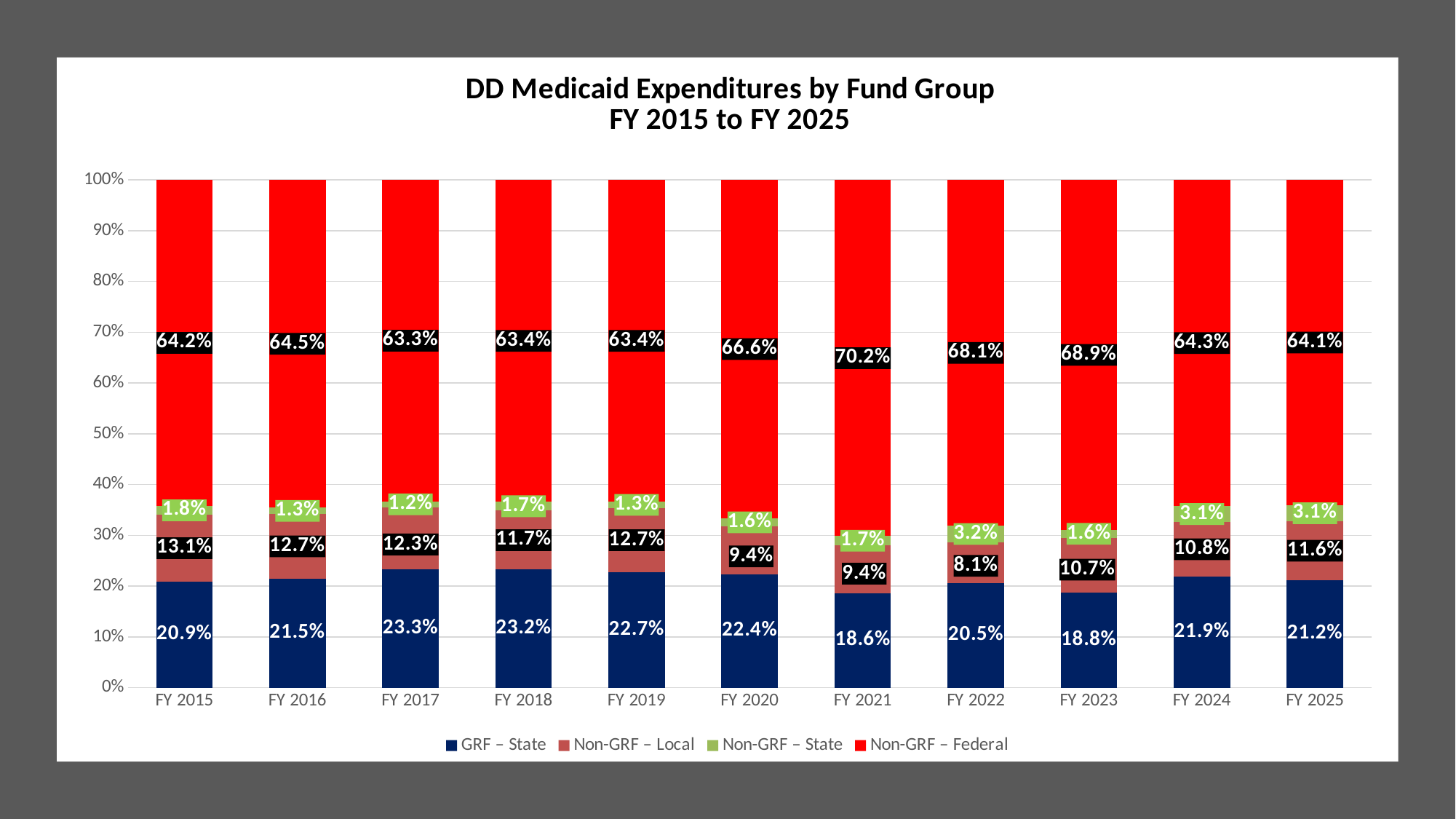
What is the Non-GRF – Federal share for FY 2021? 70.2% How many fiscal years are shown on the x axis? 11 Which is larger, the GRF – State share in FY 2018 or in FY 2023? FY 2018 In which fiscal year is the Non-GRF – Local share lowest? FY 2022 What is the Non-GRF – State share for FY 2024? 3.1% How many series does the legend list? 4 What is the GRF – State share for FY 2017? 23.3% What kind of chart is shown on the slide? Stacked bar chart What is the Non-GRF – Local share for FY 2022? 8.1% How many percentage points higher is the Non-GRF – Federal share in FY 2021 than in FY 2015? 6.0 percentage points In which fiscal year is the GRF – State share lowest? FY 2021 In which fiscal year is the Non-GRF – Federal share highest? FY 2021